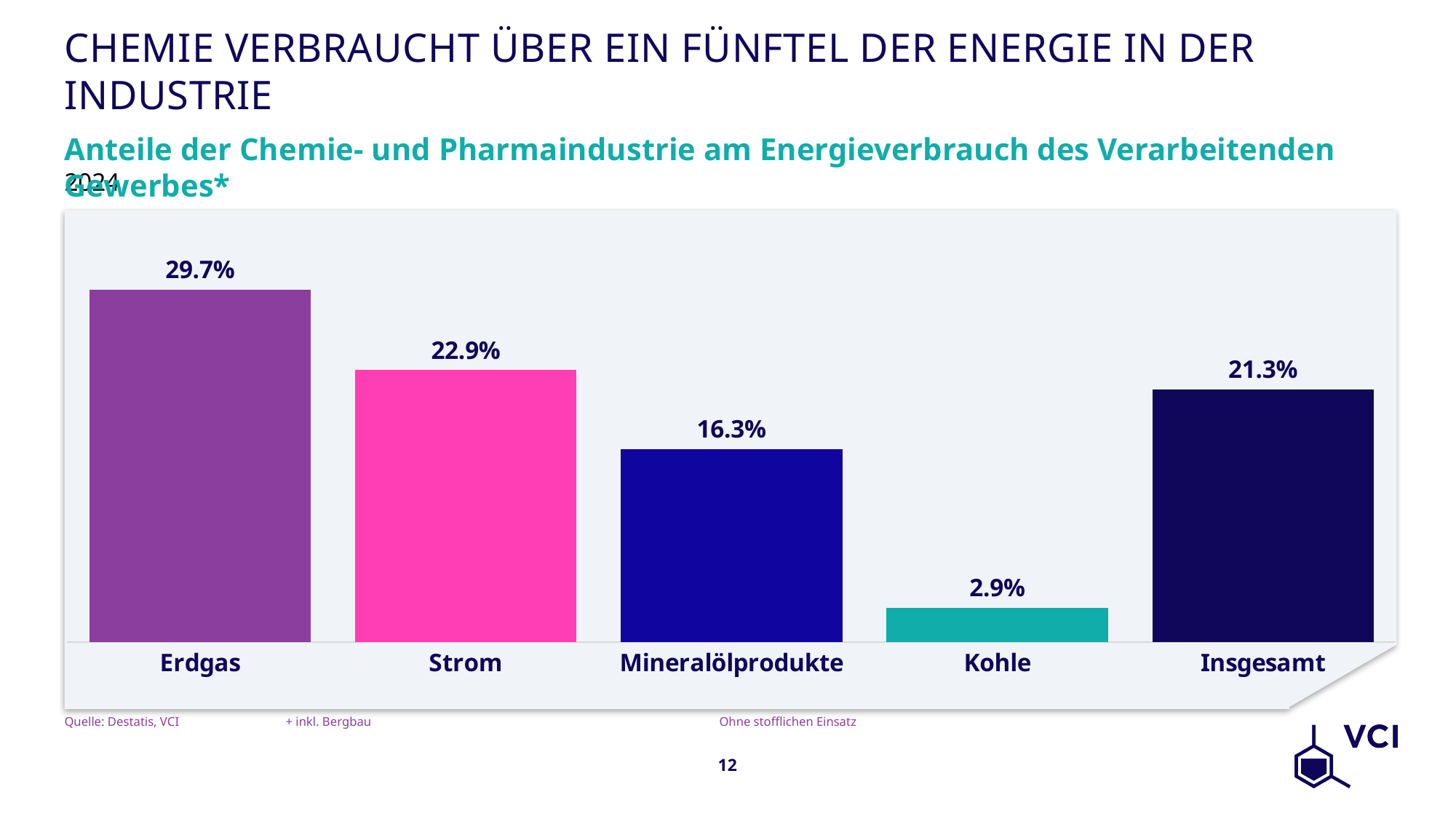
What kind of chart is shown on the slide? Bar chart What is the difference between the values for Insgesamt and Mineralölprodukte? 5.0% How many categories are shown in the chart? 5 Which category has the lowest value? Kohle Which is larger, the value for Strom or the value for Insgesamt? Strom Which category has the highest value? Erdgas What is the value for Erdgas? 29.7% What is the value for Strom? 22.9% What is the value for Mineralölprodukte? 16.3% What is the difference between the values for Erdgas and Strom? 6.8% What is the value for Insgesamt? 21.3% What is the value for Kohle? 2.9%